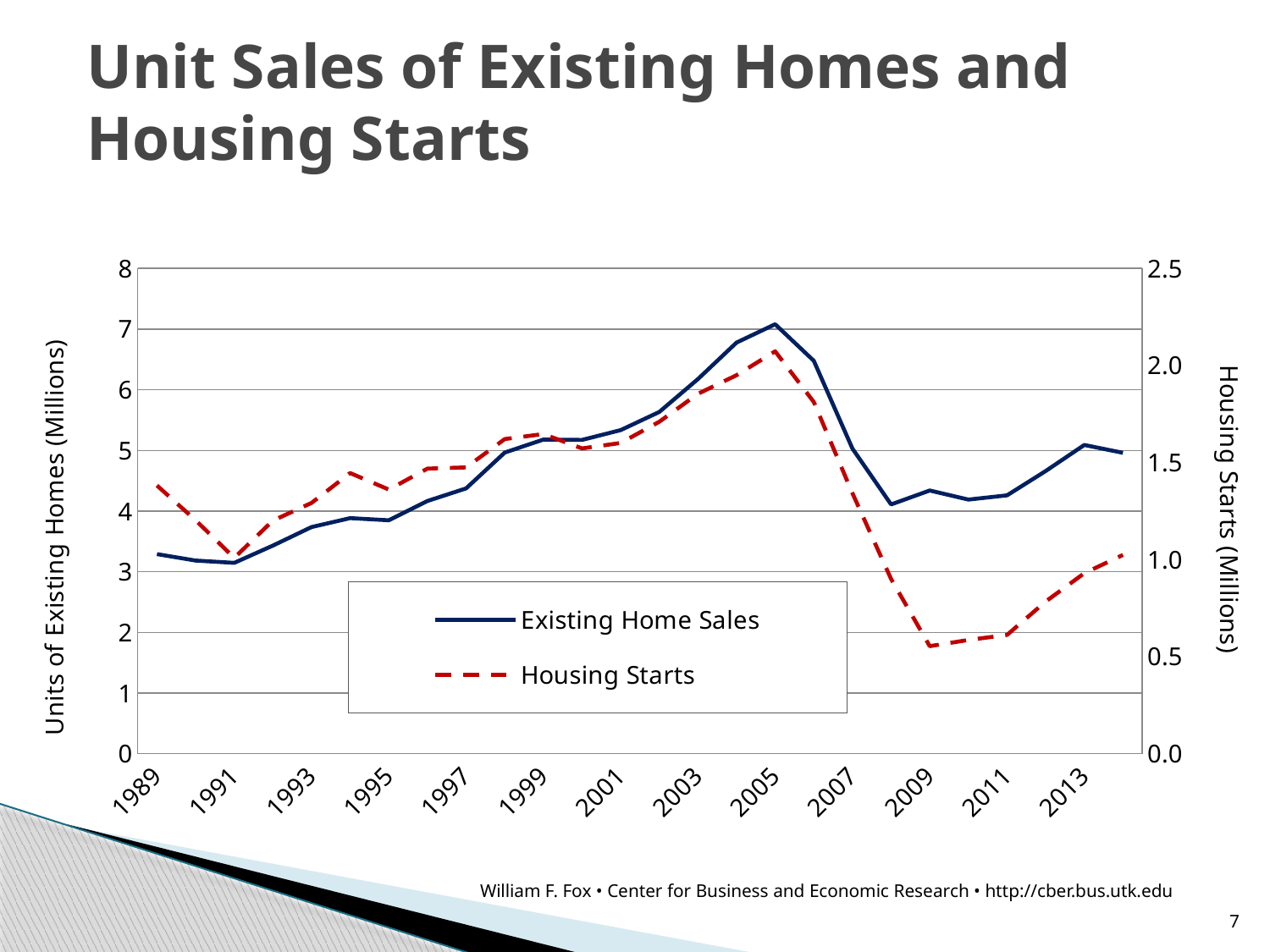
What kind of chart is shown on the slide? line chart Is the value for Existing Home Sales in 1989 greater or less than 4? less How many series does the legend list? 2 Which series is drawn with a dashed red line? Housing Starts Is the value for Housing Starts in 2009 greater or less than 1.0? less What is the title of the left vertical axis? Units of Existing Homes (Millions) Is the value for Existing Home Sales in 2005 greater or less than 6? greater Does Housing Starts rise or fall between 2005 and 2009? fall Does Existing Home Sales rise or fall between 1991 and 2005? rise In which year does Existing Home Sales reach its highest value? 2005 In which year does Housing Starts reach its lowest value? 2009